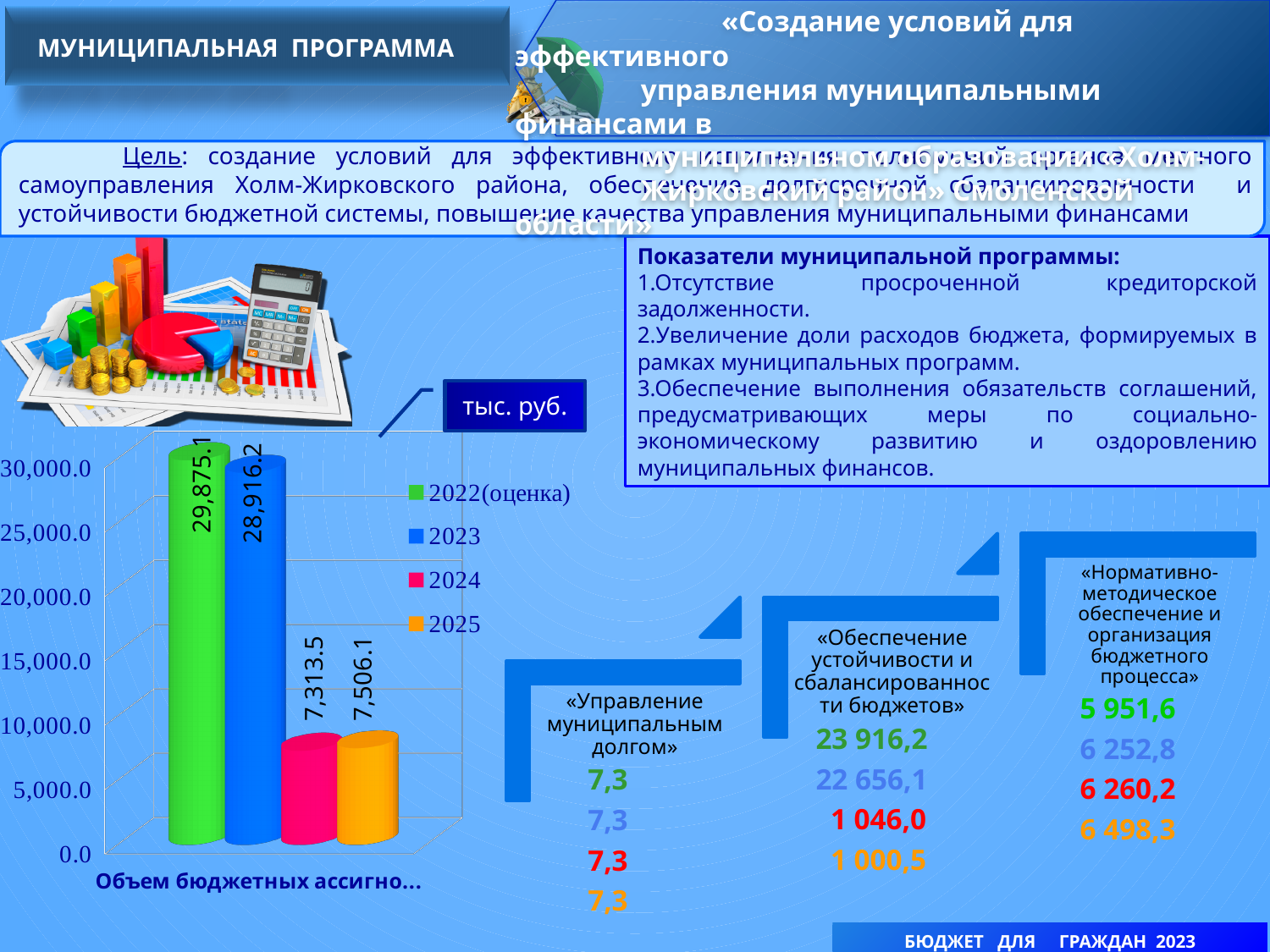
Which is larger in the chart, the value for 2024 or the value for 2025? 2025 What is the value for the 2024 series in the chart? 7,313.5 What is the value for the 2022(оценка) series in the chart? 29,875.1 What unit is indicated for the values in the chart? тыс. руб. What type of chart is shown on the slide? bar chart Which series has the lowest value in the chart? 2024 What is the value for the 2025 series in the chart? 7,506.1 How many series does the chart legend list? 4 What is the value for the 2023 series in the chart? 28,916.2 Which series has the highest value in the chart? 2022(оценка) Is the value for 2023 in the chart greater or less than 25,000.0? greater What is the difference between the 2022(оценка) value and the 2023 value in the chart? 958.9